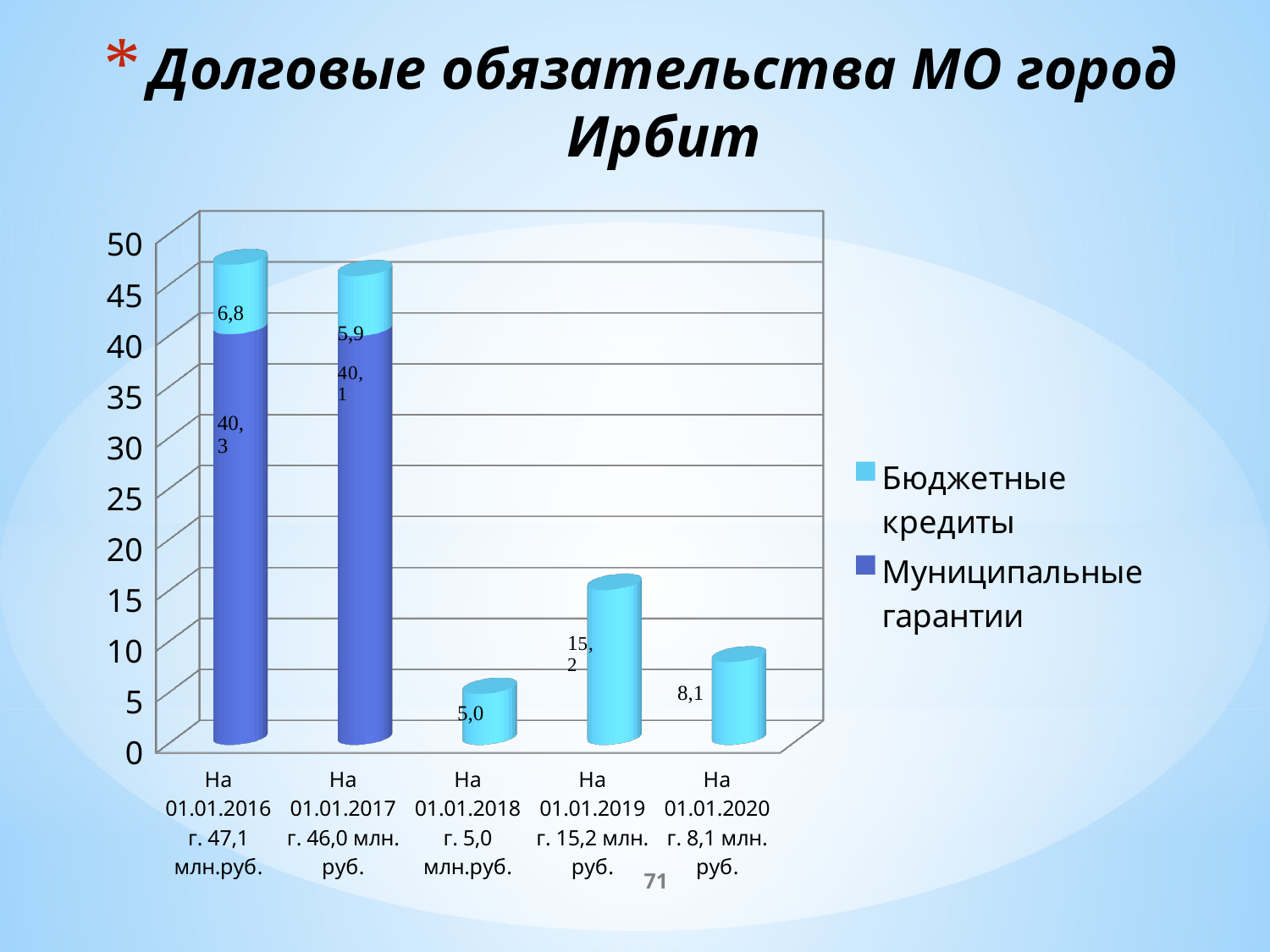
What type of chart is shown on the slide? bar chart How many categories (dates) are shown on the x axis? 5 What is the value of Бюджетные кредиты for На 01.01.2019 г.? 15,2 How many series does the legend list? 2 What is the total of the stacked bar for На 01.01.2016 г.? 47,1 Which is larger: the Бюджетные кредиты value for На 01.01.2016 г. or for На 01.01.2018 г.? На 01.01.2016 г. What is the difference between the Бюджетные кредиты values for На 01.01.2019 г. and На 01.01.2020 г.? 7,1 What is the value of Бюджетные кредиты for На 01.01.2017 г.? 5,9 Which date has the highest total debt? На 01.01.2016 г. What is the value of Муниципальные гарантии for На 01.01.2016 г.? 40,3 Which date has the lowest total debt? На 01.01.2018 г. What is the total of the stacked bar for На 01.01.2017 г.? 46,0